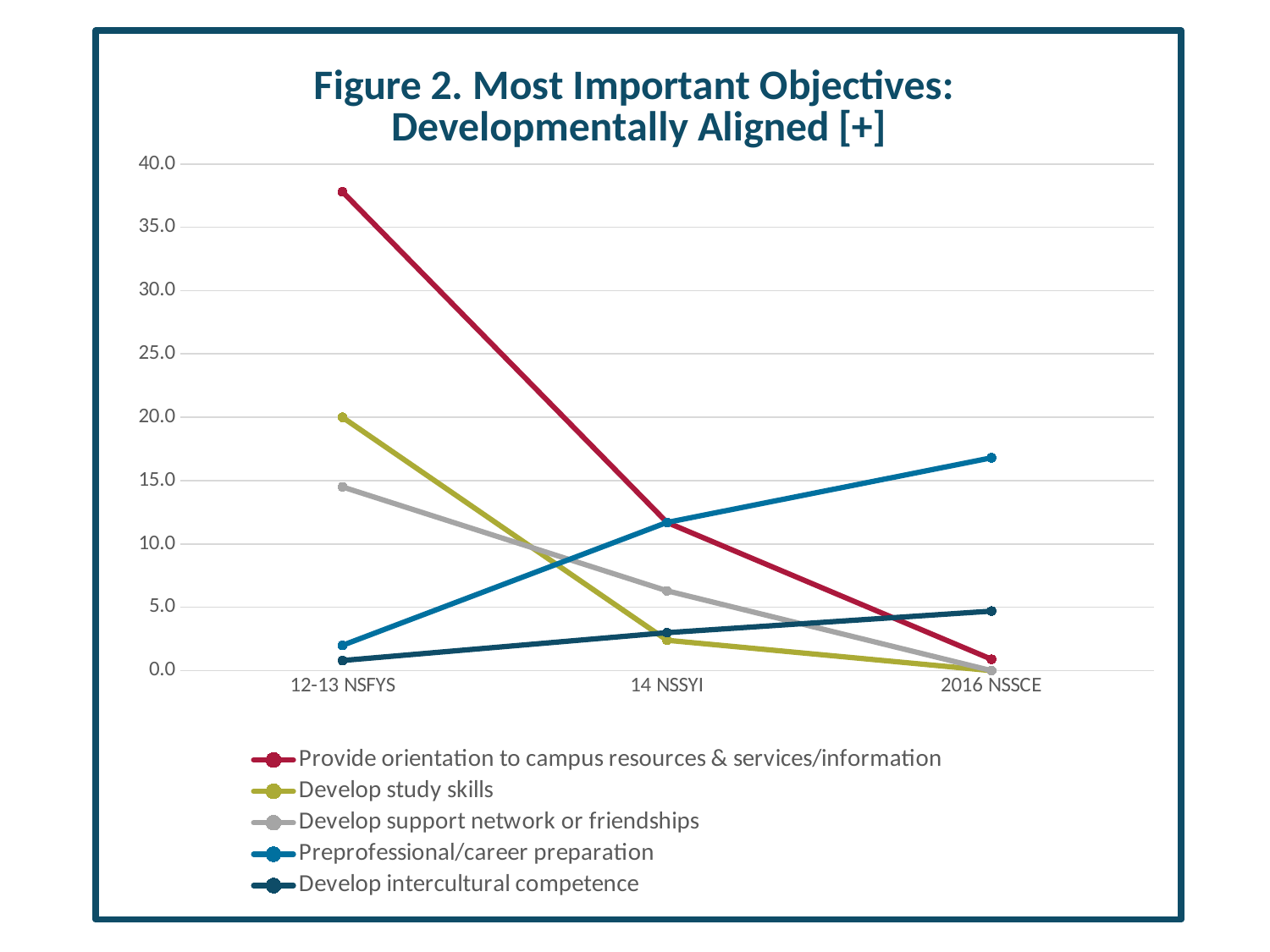
Which series has the lowest value at 12-13 NSFYS? Develop intercultural competence How many series does the legend list? 5 How many categories are shown along the x axis? 3 What kind of chart is shown on the slide? line chart Which series has the highest value at 12-13 NSFYS? Provide orientation to campus resources & services/information Is the value for 'Provide orientation to campus resources & services/information' at 12-13 NSFYS greater or less than 35.0? greater Do the values for 'Preprofessional/career preparation' rise or fall from 12-13 NSFYS to 2016 NSSCE? rise Which series has the highest value at 2016 NSSCE? Preprofessional/career preparation What is the title of the chart? Figure 2. Most Important Objectives: Developmentally Aligned [+] Is the value for 'Preprofessional/career preparation' at 2016 NSSCE greater or less than 15.0? greater Do the values for 'Provide orientation to campus resources & services/information' rise or fall from 12-13 NSFYS to 2016 NSSCE? fall At 14 NSSYI, which is larger: 'Develop support network or friendships' or 'Develop study skills'? Develop support network or friendships